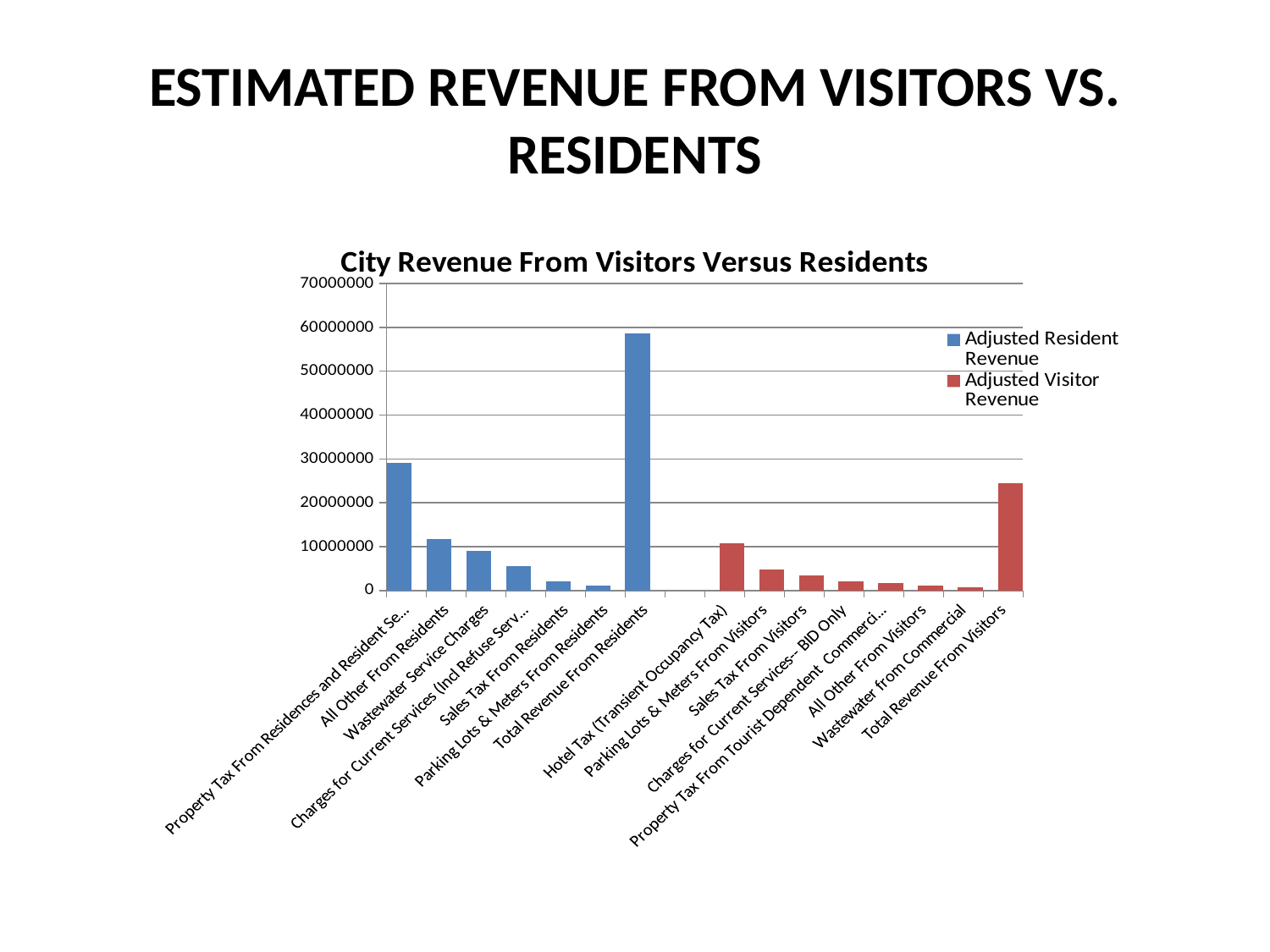
How many bars belong to the Adjusted Visitor Revenue series? 8 What is the title of the chart? City Revenue From Visitors Versus Residents Is the value for Total Revenue From Visitors greater or less than 30000000? less Which category has the highest bar in the chart? Total Revenue From Residents How many series does the legend list? 2 Is the value for Sales Tax From Visitors greater or less than 10000000? less Which is larger, Hotel Tax (Transient Occupancy Tax) or Sales Tax From Visitors? Hotel Tax (Transient Occupancy Tax) Which is larger, Total Revenue From Residents or Total Revenue From Visitors? Total Revenue From Residents What kind of chart is shown on the slide? bar chart Is the value for Wastewater Service Charges greater or less than 10000000? less Which series is shown in red? Adjusted Visitor Revenue